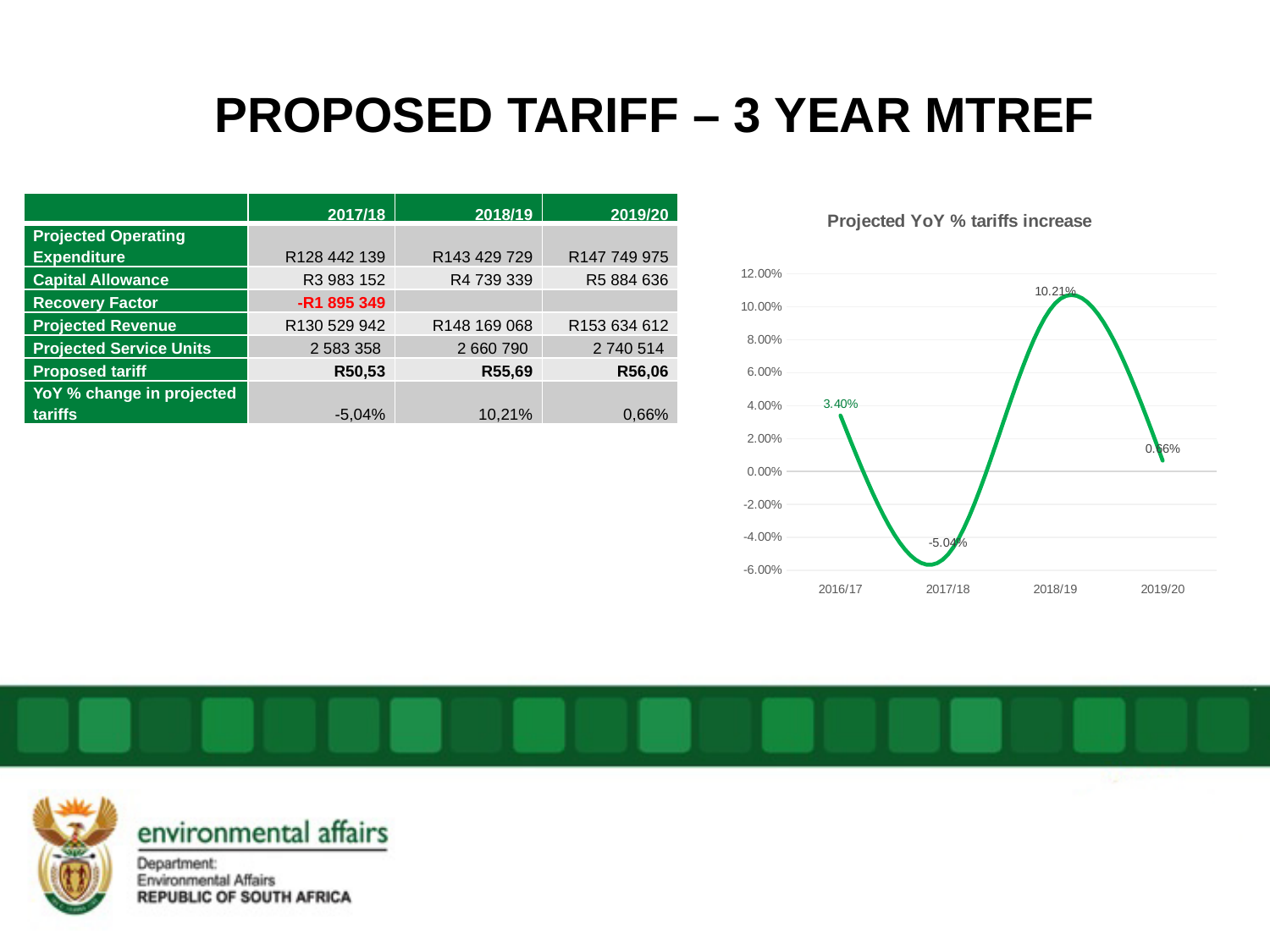
What is the projected YoY % tariffs increase for 2016/17? 3.40% Which year has the lowest projected YoY % tariffs increase? 2017/18 What is the projected YoY % tariffs increase for 2018/19? 10.21% What is the projected YoY % tariffs increase for 2019/20? 0.66% What is the difference between the values for 2018/19 and 2016/17? 6.81% Which is larger, the value for 2016/17 or the value for 2019/20? 2016/17 Which year has the highest projected YoY % tariffs increase? 2018/19 Does the value fall or rise from 2018/19 to 2019/20? fall How many years are plotted on the chart? 4 What is the projected YoY % tariffs increase for 2017/18? -5.04% What type of chart is shown on the slide? line chart What is the title of the chart? Projected YoY % tariffs increase